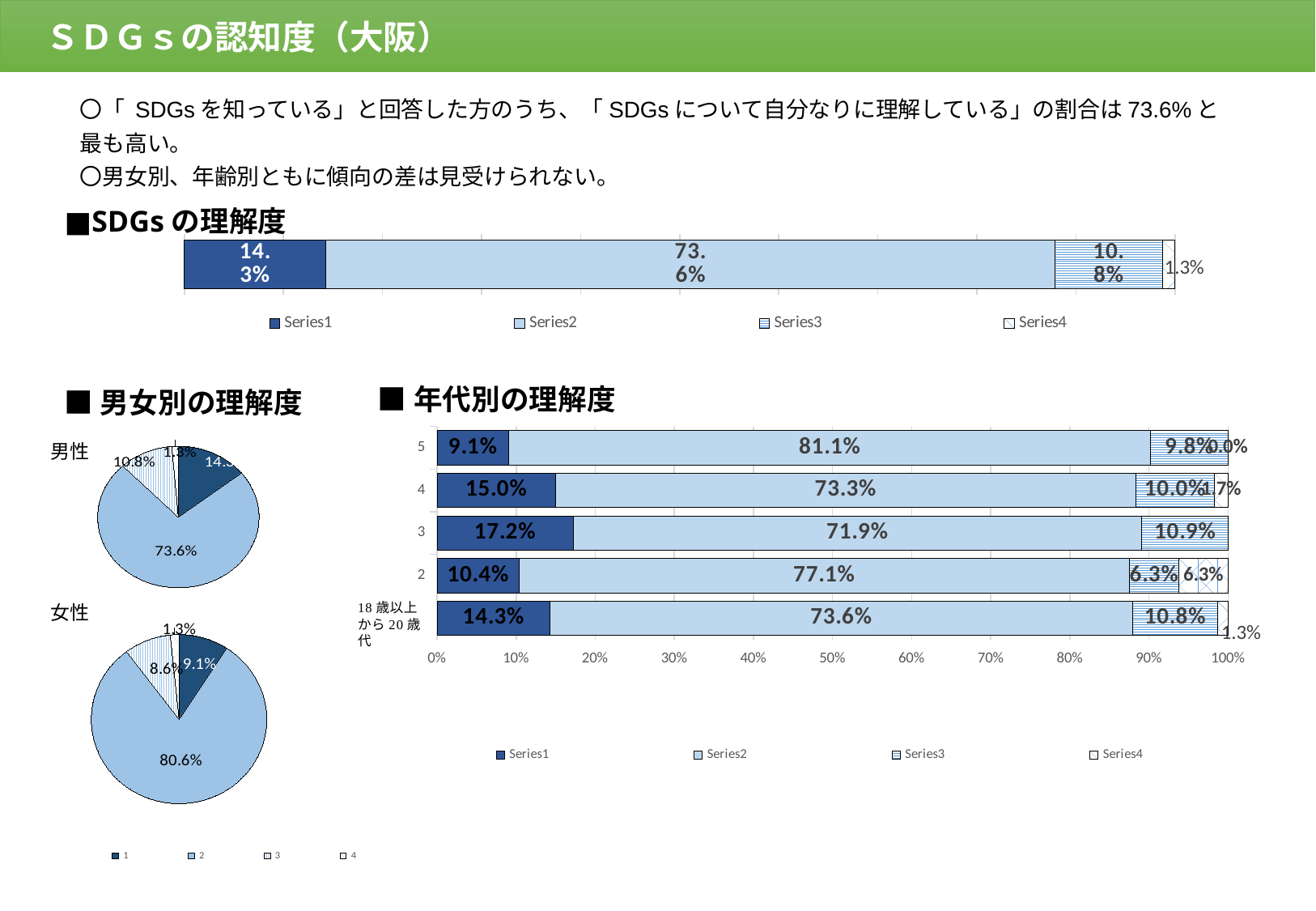
In the 年代別の理解度 chart, what is the difference between the Series2 values for category 5 and category 3? 9.2% In the 年代別の理解度 chart, what is the Series2 value for category 5? 81.1% How many series does the legend of the SDGsの理解度 chart at the top list? 4 How many categories are shown in the 年代別の理解度 chart? 5 In the SDGsの理解度 chart at the top, what is the value for Series1? 14.3% In the 年代別の理解度 chart, is the Series2 value for category 2 larger or smaller than that for category 4? Larger What kind of chart is used for the 男女別の理解度 section? Pie chart In the SDGsの理解度 chart at the top, what is the value for Series2? 73.6% In the 女性 pie chart, what is the value of the largest slice? 80.6% In the 年代別の理解度 chart, which category has the highest Series1 value? 3 In the 年代別の理解度 chart, what is the Series1 value for category 3? 17.2%